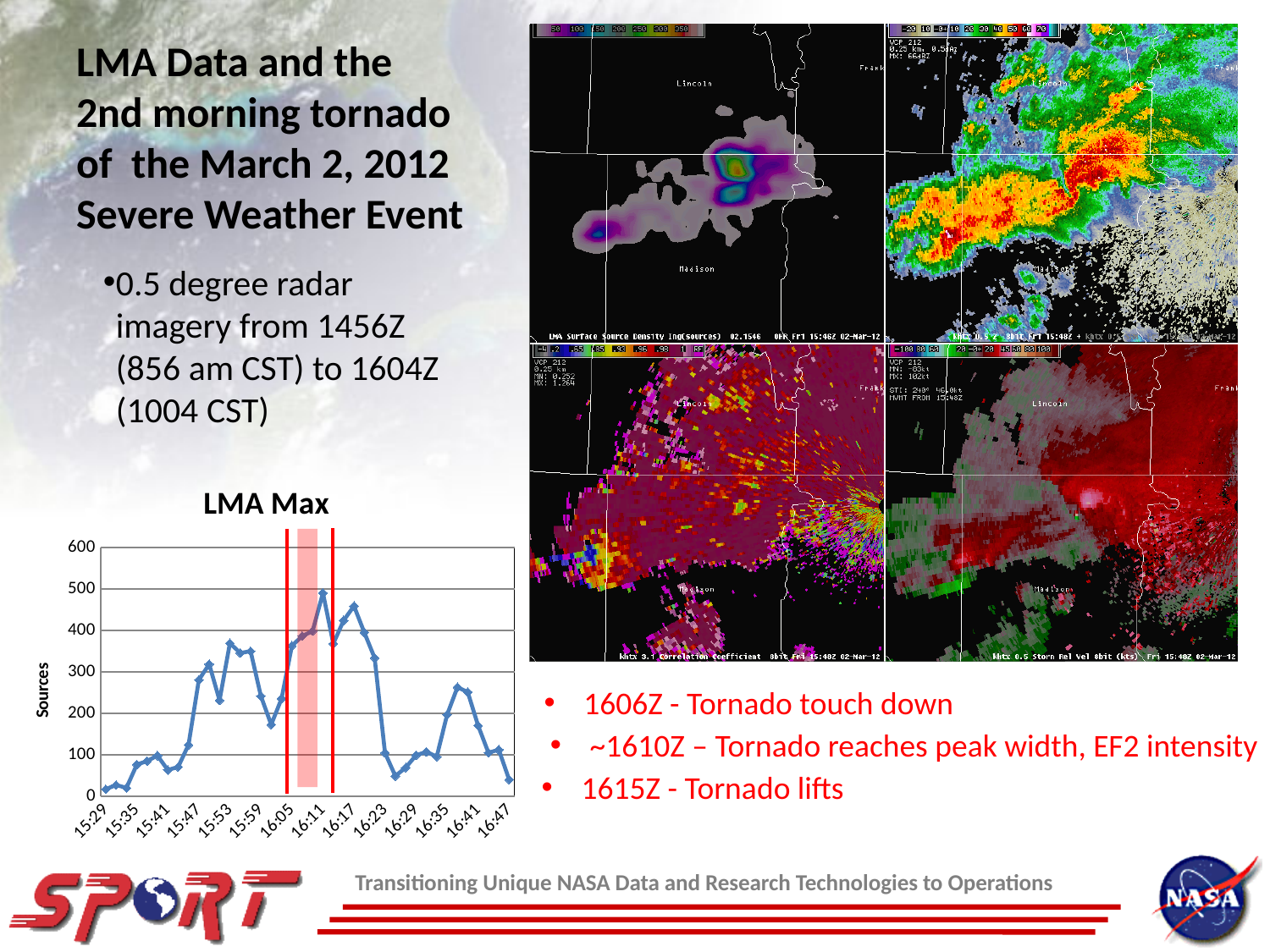
Is the value at 16:11 on the LMA Max chart greater or less than 400? greater Is the value at 15:29 on the LMA Max chart greater or less than 100? less Which has the larger value on the LMA Max chart, 15:53 or 16:35? 15:53 Is the value at 15:53 on the LMA Max chart greater or less than 300? greater What kind of chart is the LMA Max chart? line chart At which labelled time is the value on the LMA Max chart lowest? 15:29 Do the values on the LMA Max chart generally rise or fall from 15:29 to 16:11? rise What is the title of the chart on the slide? LMA Max How many time labels are shown on the x axis of the LMA Max chart? 14 What is the label on the y axis of the LMA Max chart? Sources At which time does the LMA Max chart reach its highest value? 16:11